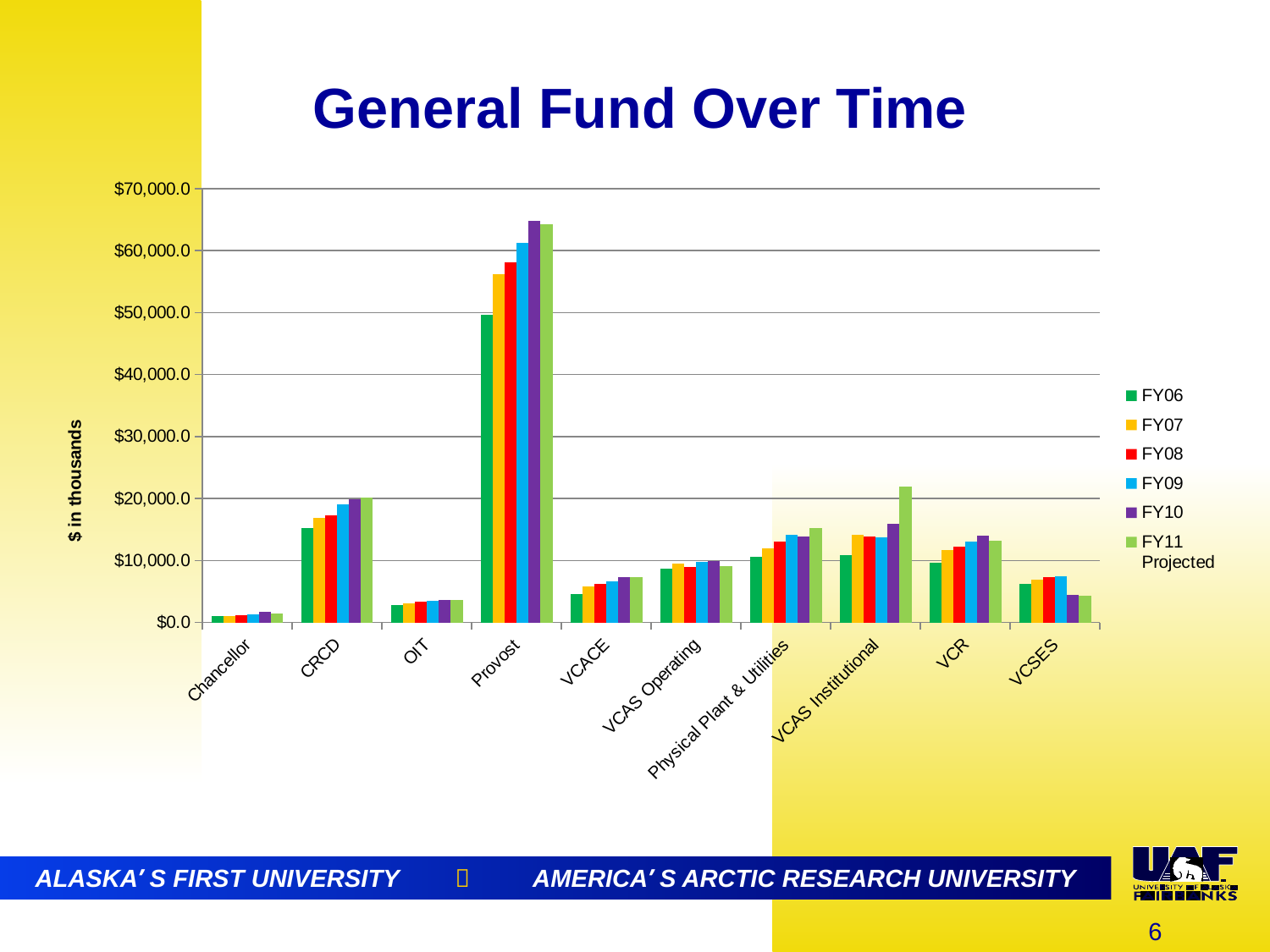
Is the FY06 value for OIT greater or less than $10,000.0? less Is the FY10 value for Provost greater or less than $60,000.0? greater Do the Provost values rise or fall from FY06 to FY10? rise How many categories are shown on the x axis? 10 How many series does the legend list? 6 What is the title of the chart? General Fund Over Time Is the FY11 Projected value for VCAS Institutional greater or less than $20,000.0? greater What is the label on the y axis? $ in thousands What type of chart is shown on the slide? bar chart Which category has the lowest values in the chart? Chancellor Which category has the highest values in the chart? Provost Which is larger for FY11 Projected: VCAS Institutional or VCR? VCAS Institutional